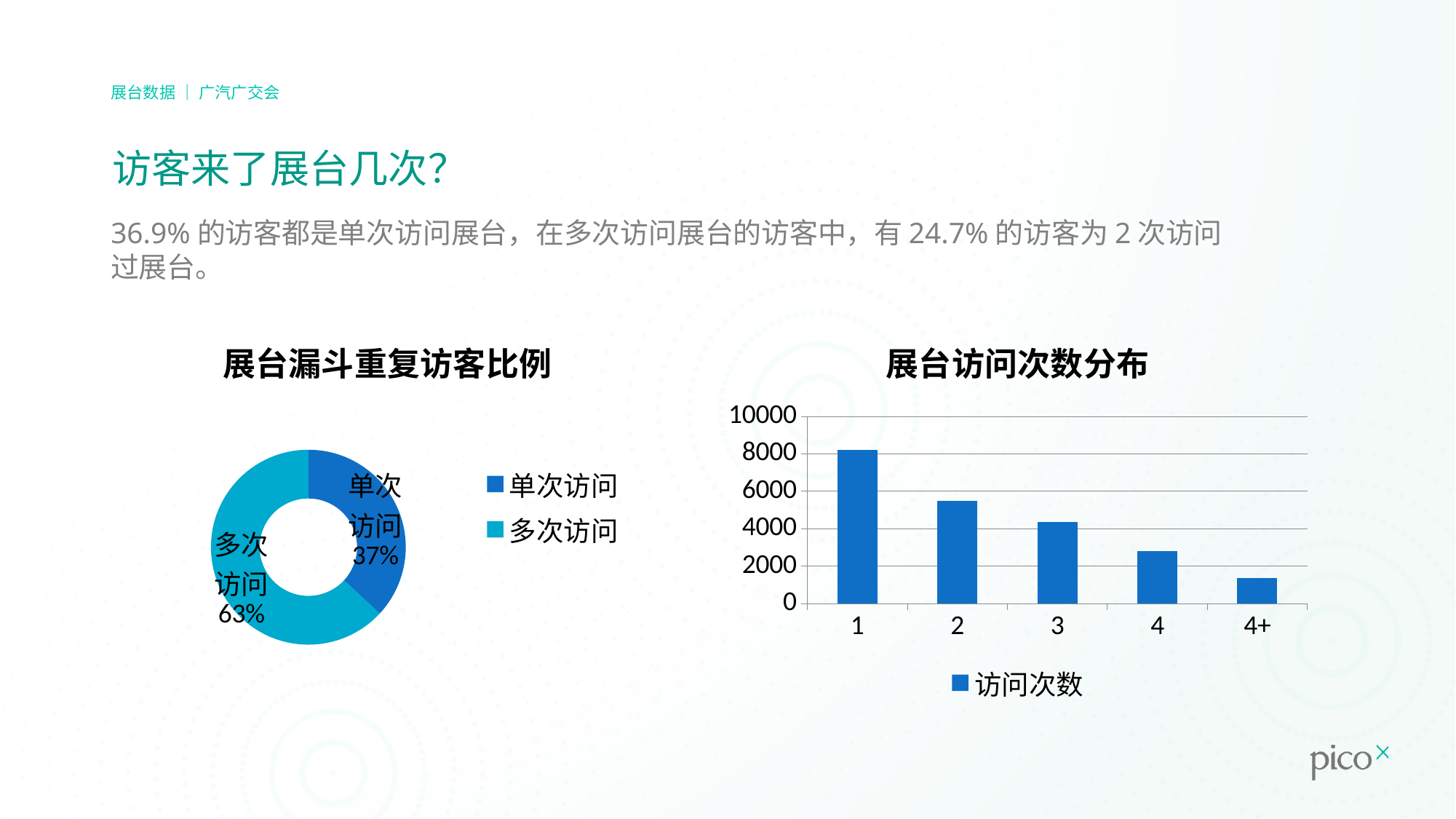
On the chart titled 展台漏斗重复访客比例, how many entries does the legend list? 2 On the chart titled 展台漏斗重复访客比例, what is the difference in percentage points between 多次访问 and 单次访问? 26 On the chart titled 展台漏斗重复访客比例, which slice is larger, 单次访问 or 多次访问? 多次访问 On the chart titled 展台访问次数分布, which category has the highest value? 1 What kind of chart is the one titled 展台访问次数分布? bar chart On the chart titled 展台访问次数分布, is the value for category 1 greater or less than 6000? greater On the chart titled 展台漏斗重复访客比例, what share of visitors is 单次访问? 37% On the chart titled 展台访问次数分布, which category has the lowest value? 4+ On the chart titled 展台访问次数分布, how many categories are shown on the x axis? 5 On the chart titled 展台访问次数分布, do the values rise or fall as you move from category 1 to 4+? fall On the chart titled 展台访问次数分布, is the value for category 4+ greater or less than 2000? less On the chart titled 展台漏斗重复访客比例, what share of visitors is 多次访问? 63%